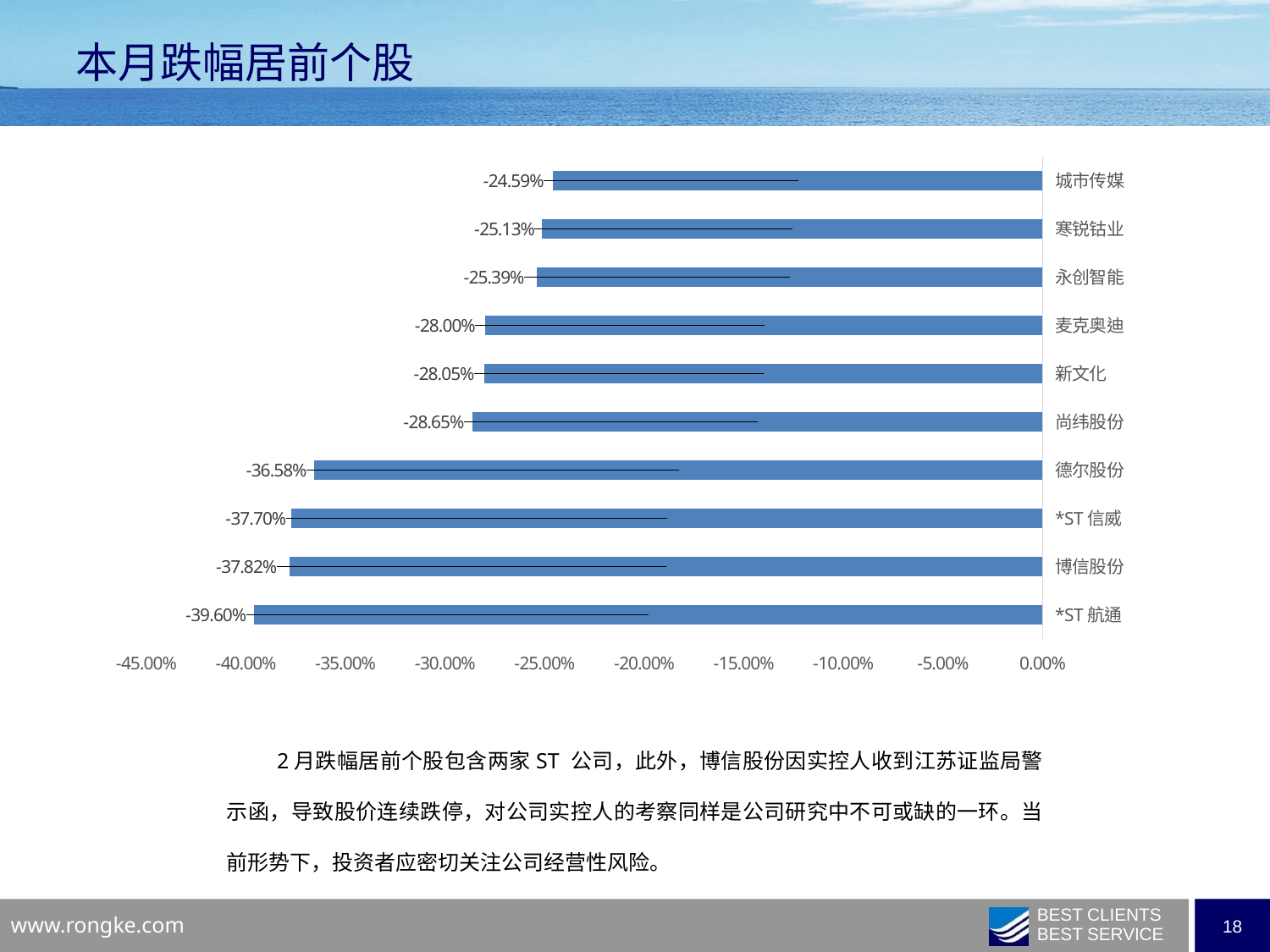
How many stocks are shown on the chart? 10 What is the value shown for 德尔股份? -36.58% Which stock has the largest decline (the lowest value) on the chart? *ST 航通 Which has a larger decline, 尚纬股份 or 麦克奥迪? 尚纬股份 What is the difference between the values for 博信股份 and *ST 信威? 0.12% What is the difference between the values for 城市传媒 and *ST 航通? 15.01% What is the value shown for 新文化? -28.05% What is the value shown for *ST 航通? -39.60% What is the title of the slide? 本月跌幅居前个股 What type of chart is shown on the slide? Bar chart Which stock has the smallest decline (the highest value) on the chart? 城市传媒 What is the value shown for 城市传媒? -24.59%